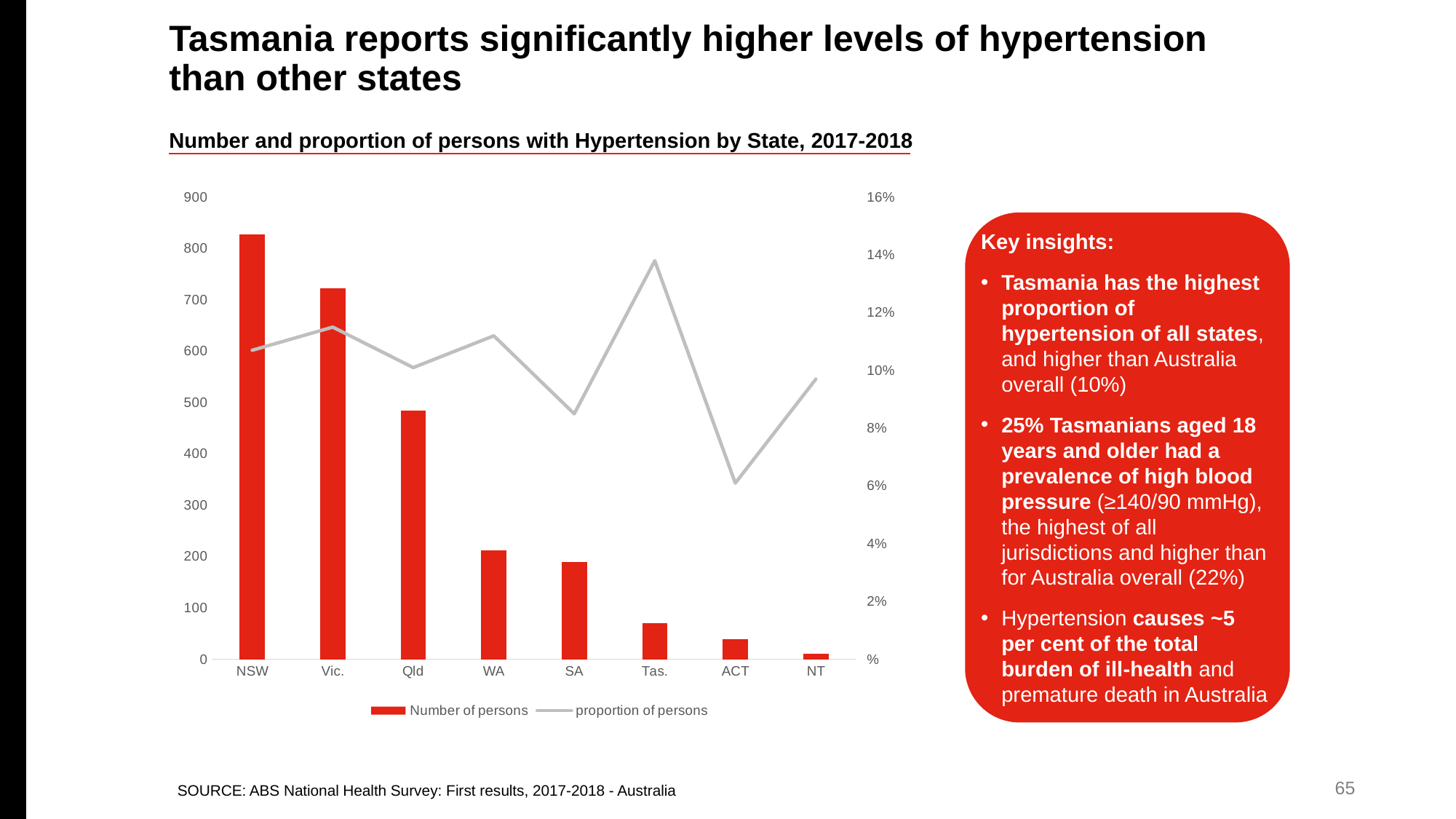
Does the number of persons rise or fall moving from NSW to NT along the x axis? fall Which has a larger number of persons with hypertension, Vic. or Qld? Vic. Which state has the highest number of persons with hypertension? NSW Which state or territory has the lowest proportion of persons with hypertension? ACT How many states or territories are shown on the x axis? 8 What kind of chart is shown on the slide? A combination bar and line chart Is the number of persons for NSW greater or less than 800? greater Which state or territory has the lowest number of persons with hypertension? NT Which state has the highest proportion of persons with hypertension? Tas. How many series does the legend list? 2 Is the proportion of persons for Tas. greater or less than 12%? greater Is the number of persons for WA greater or less than 300? less